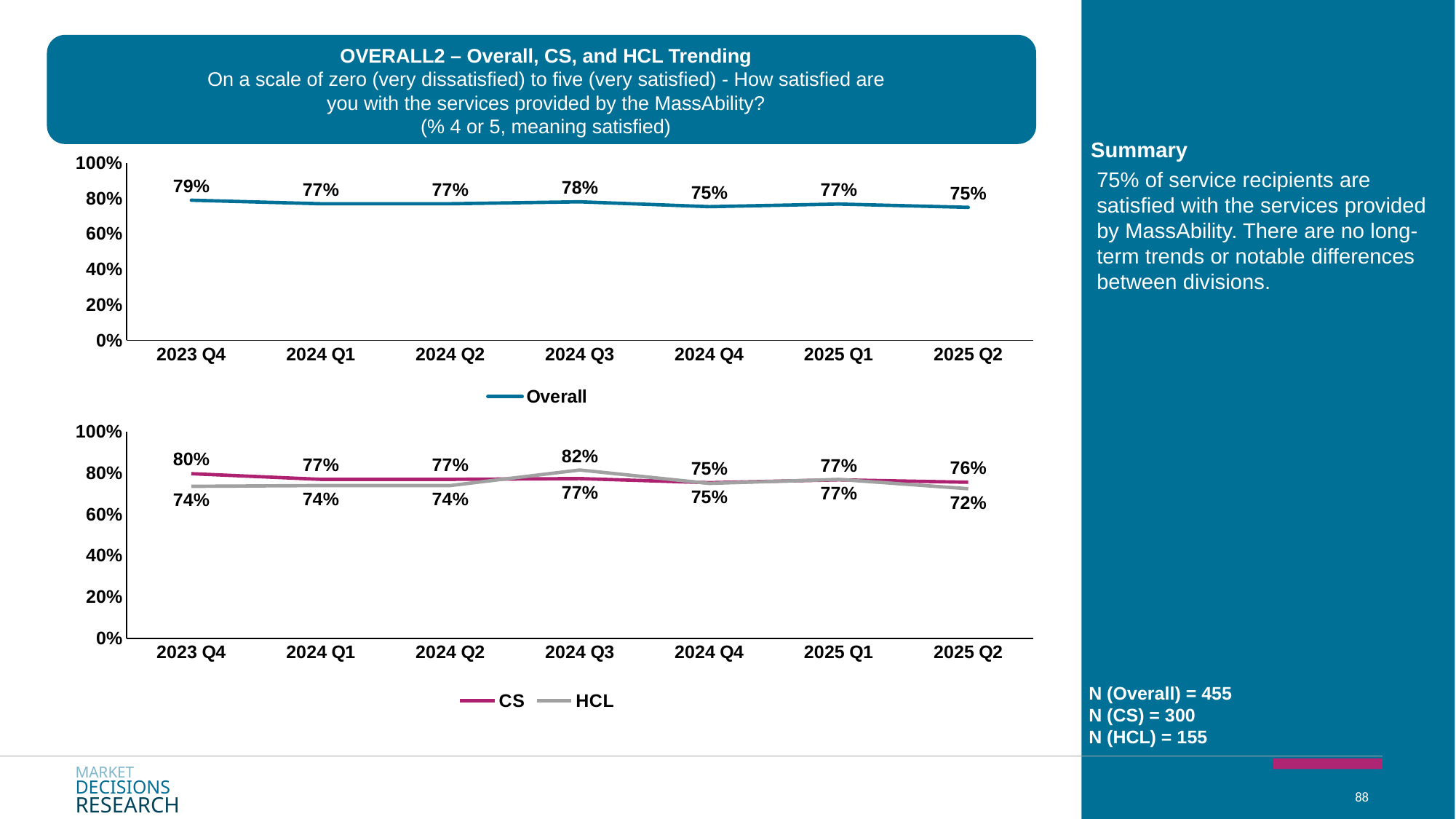
In the bottom chart, what is the HCL value for 2025 Q2? 72% In the top chart (Overall), what is the value for 2023 Q4? 79% In the top chart (Overall), which quarter has the highest value? 2023 Q4 In the bottom chart, which is larger at 2023 Q4, CS or HCL? CS In the top chart (Overall), what is the difference between the 2023 Q4 value and the 2025 Q2 value? 4 percentage points How many series does the legend of the bottom chart list? 2 In the bottom chart, what is the difference between the CS and HCL values at 2023 Q4? 6 percentage points What type of chart is the top chart? Line chart In the top chart (Overall), how many quarters are plotted? 7 In the bottom chart, what is the CS value for 2023 Q4? 80% In the bottom chart, is the HCL value for 2024 Q1 greater or less than 80%? less In the top chart (Overall), what is the value for 2025 Q2? 75%